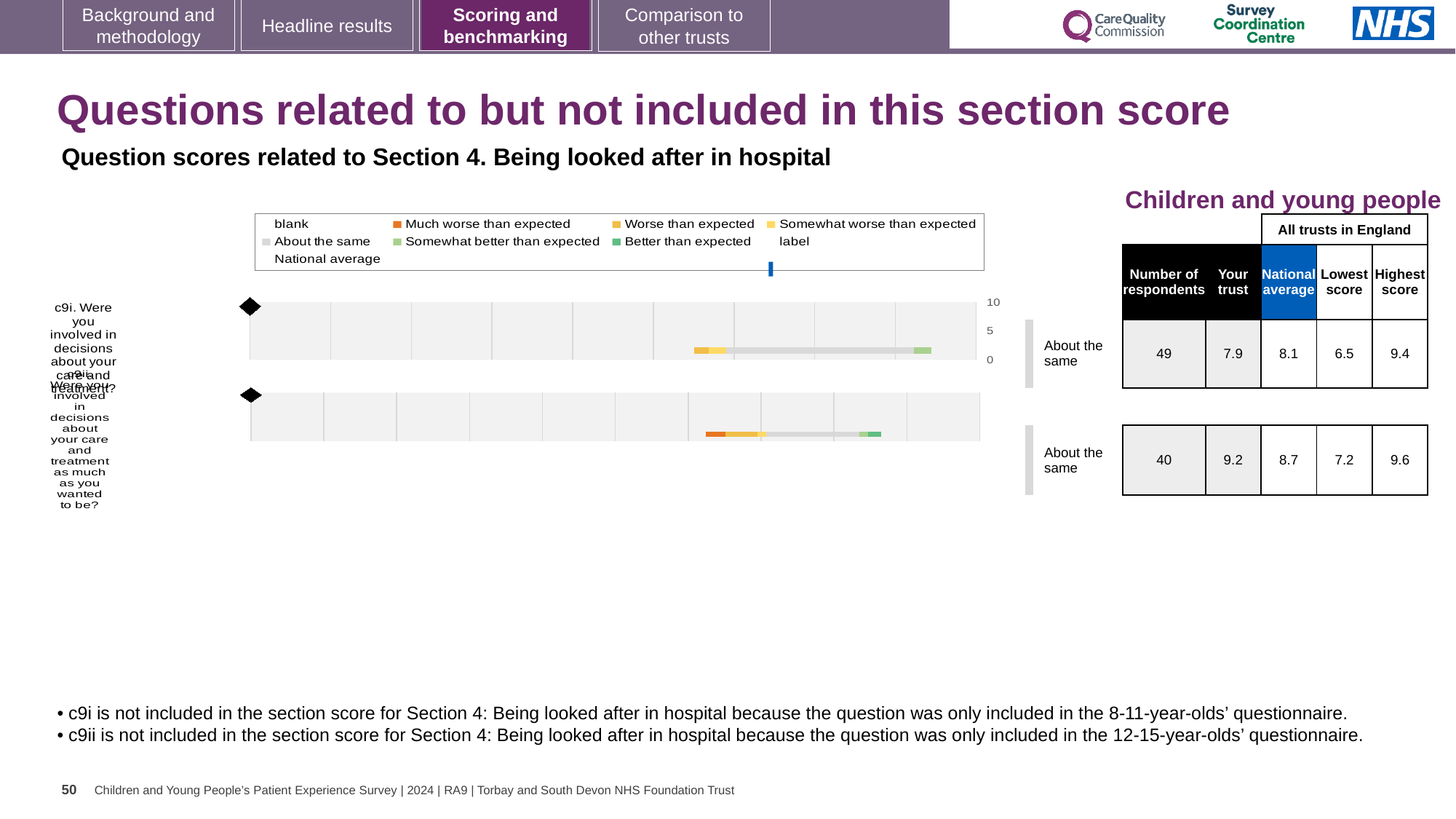
In the table, what is the National average score for c9ii? 8.7 Which question has the lower 'Your trust' score, c9i or c9ii? c9i In the table, what is the Highest score across all trusts in England for c9i? 9.4 What is the difference between the Highest score and the Lowest score for c9i? 2.9 What benchmark category is shown next to the bar for c9i? About the same In the table, what is the 'Your trust' score for c9i? 7.9 For c9ii, which is larger: the 'Your trust' score or the National average? Your trust In the table, how many respondents answered c9ii? 40 How many questions (c9i and c9ii) are plotted as bars on the slide? 2 What is the highest value shown on the chart's numeric axis? 10 What is the difference between the 'Your trust' score and the National average for c9ii? 0.5 What kind of chart is used to show the question scores for c9i and c9ii? bar chart